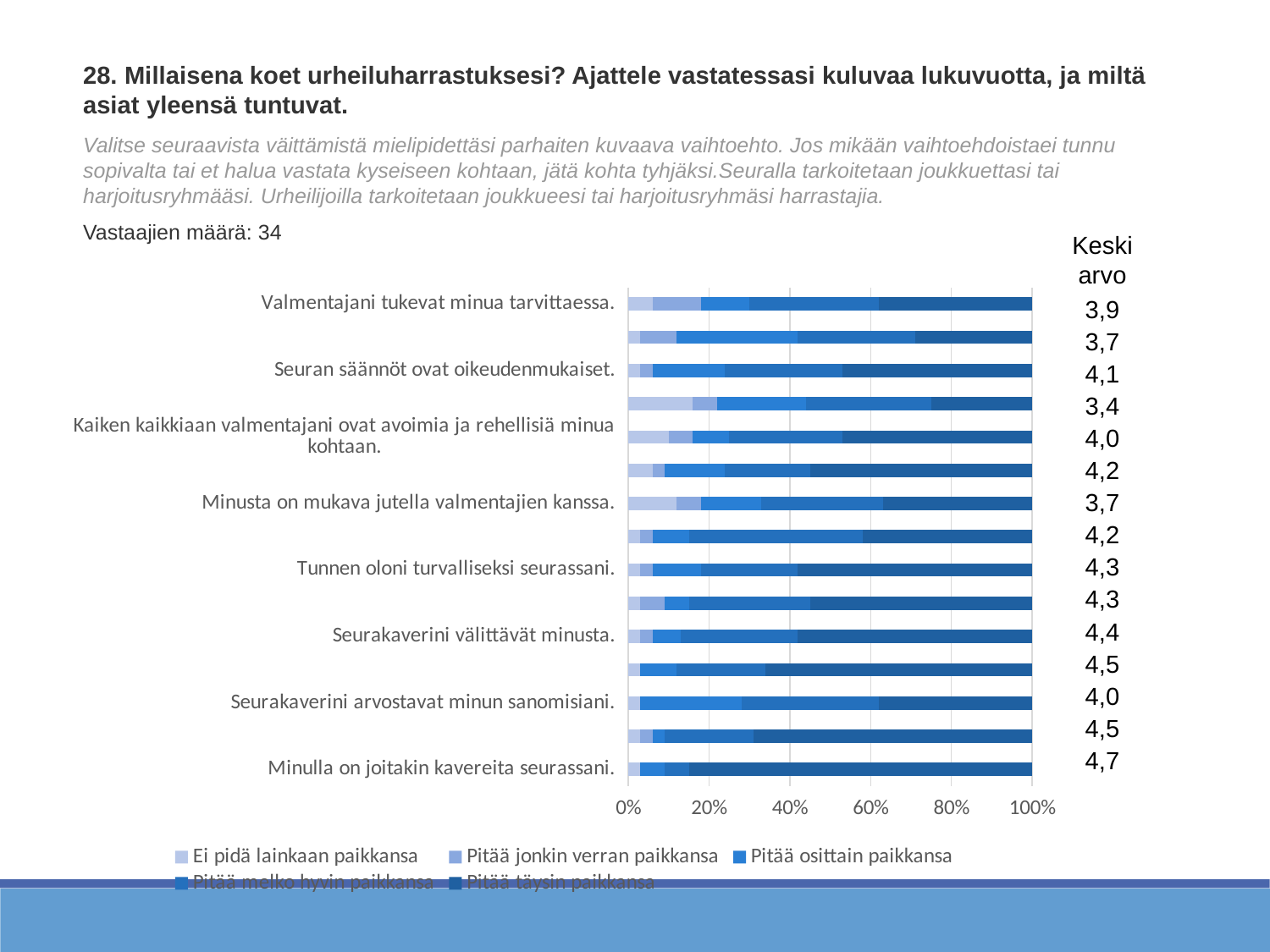
How many bars are plotted in the chart? 15 What kind of chart is shown on the slide? Stacked bar chart How many respondents (Vastaajien määrä) does the slide report? 34 What is the mean value (Keski arvo) shown for "Minulla on joitakin kavereita seurassani."? 4,7 What is the mean value (Keski arvo) shown for "Seurakaverini välittävät minusta."? 4,4 How many series does the chart legend list? 5 What is the difference between the mean values for "Minulla on joitakin kavereita seurassani." and "Valmentajani tukevat minua tarvittaessa."? 0,8 What is the lowest mean value (Keski arvo) listed next to the chart? 3,4 Which labelled statement has the highest mean value (Keski arvo)? Minulla on joitakin kavereita seurassani. Which has a higher mean value: "Seurakaverini välittävät minusta." or "Minusta on mukava jutella valmentajien kanssa."? Seurakaverini välittävät minusta. What is the mean value (Keski arvo) shown for "Valmentajani tukevat minua tarvittaessa."? 3,9 What is the mean value (Keski arvo) shown for "Tunnen oloni turvalliseksi seurassani."? 4,3